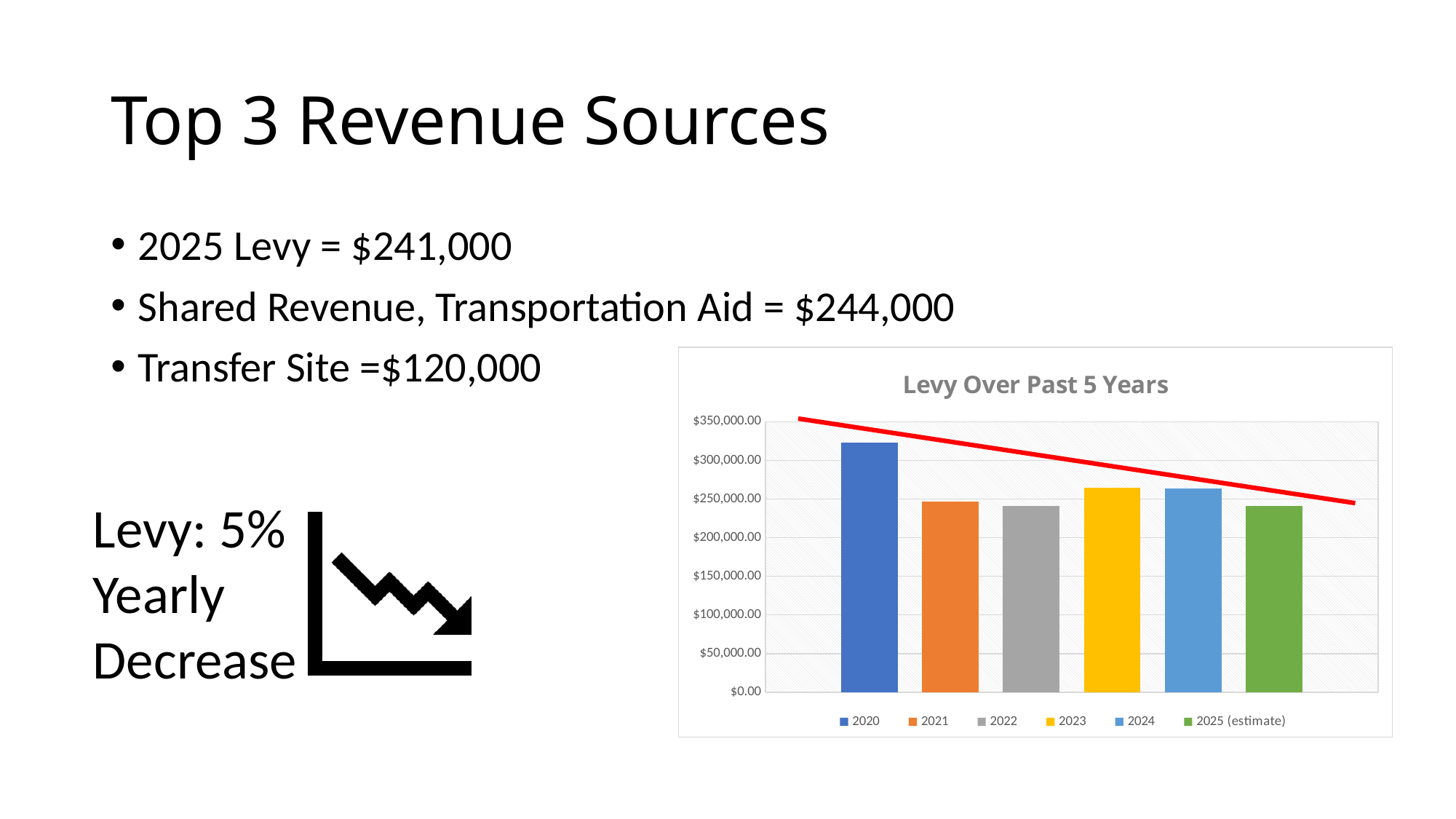
In the "Levy Over Past 5 Years" chart, is the value for 2023 greater or less than $250,000.00? greater In the "Levy Over Past 5 Years" chart, does the red trend line rise or fall from left to right? fall In the "Levy Over Past 5 Years" chart, which is larger, the value for 2022 or the value for 2023? 2023 In the "Levy Over Past 5 Years" chart, is the value for 2025 (estimate) greater or less than $250,000.00? less How many bars are plotted in the "Levy Over Past 5 Years" chart? 6 How many entries does the legend of the "Levy Over Past 5 Years" chart list? 6 What kind of chart is "Levy Over Past 5 Years"? bar chart In the "Levy Over Past 5 Years" chart, which year has the highest levy? 2020 What is the title of the chart on the slide? Levy Over Past 5 Years In the "Levy Over Past 5 Years" chart, is the value for 2020 greater or less than $300,000.00? greater In the "Levy Over Past 5 Years" chart, which is larger, the value for 2020 or the value for 2021? 2020